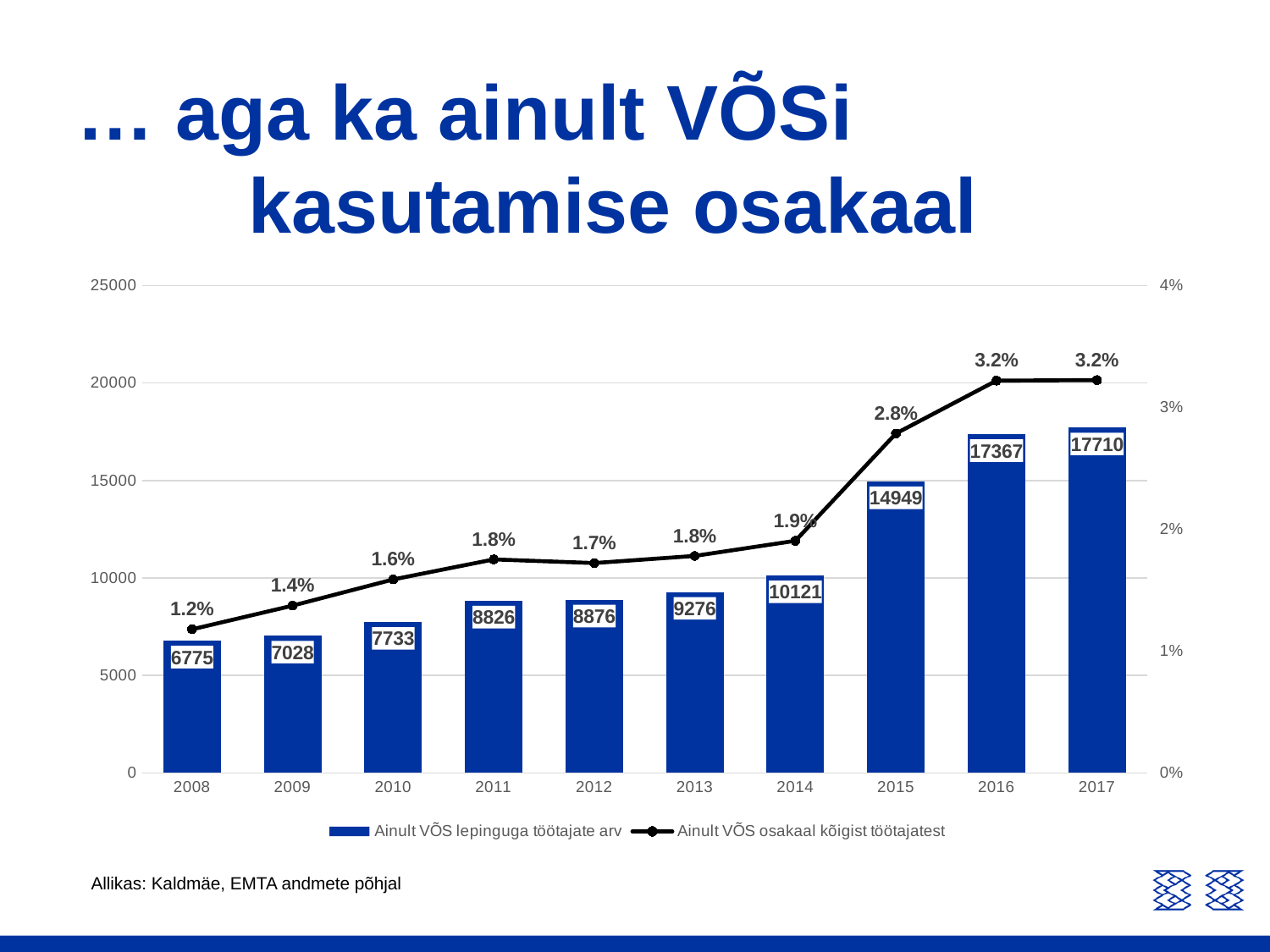
What is the value of 'Ainult VÕS osakaal kõigist töötajatest' for 2010? 1.6% Which year has the lowest value for 'Ainult VÕS osakaal kõigist töötajatest'? 2008 Which is larger, the 'Ainult VÕS osakaal kõigist töötajatest' value for 2011 or for 2012? 2011 What kind of chart is shown on the slide? Combined bar and line chart How many years are shown on the x axis? 10 What is the source given below the chart? Kaldmäe, EMTA andmete põhjal What is the value of 'Ainult VÕS lepinguga töötajate arv' for 2014? 10121 How many series does the legend list? 2 What is the difference between the 'Ainult VÕS lepinguga töötajate arv' values for 2017 and 2016? 343 Is the value for 'Ainult VÕS lepinguga töötajate arv' in 2015 greater or less than 10000? greater Which year has the highest value for 'Ainult VÕS lepinguga töötajate arv'? 2017 Do the values for 'Ainult VÕS lepinguga töötajate arv' rise or fall from 2008 to 2017? rise